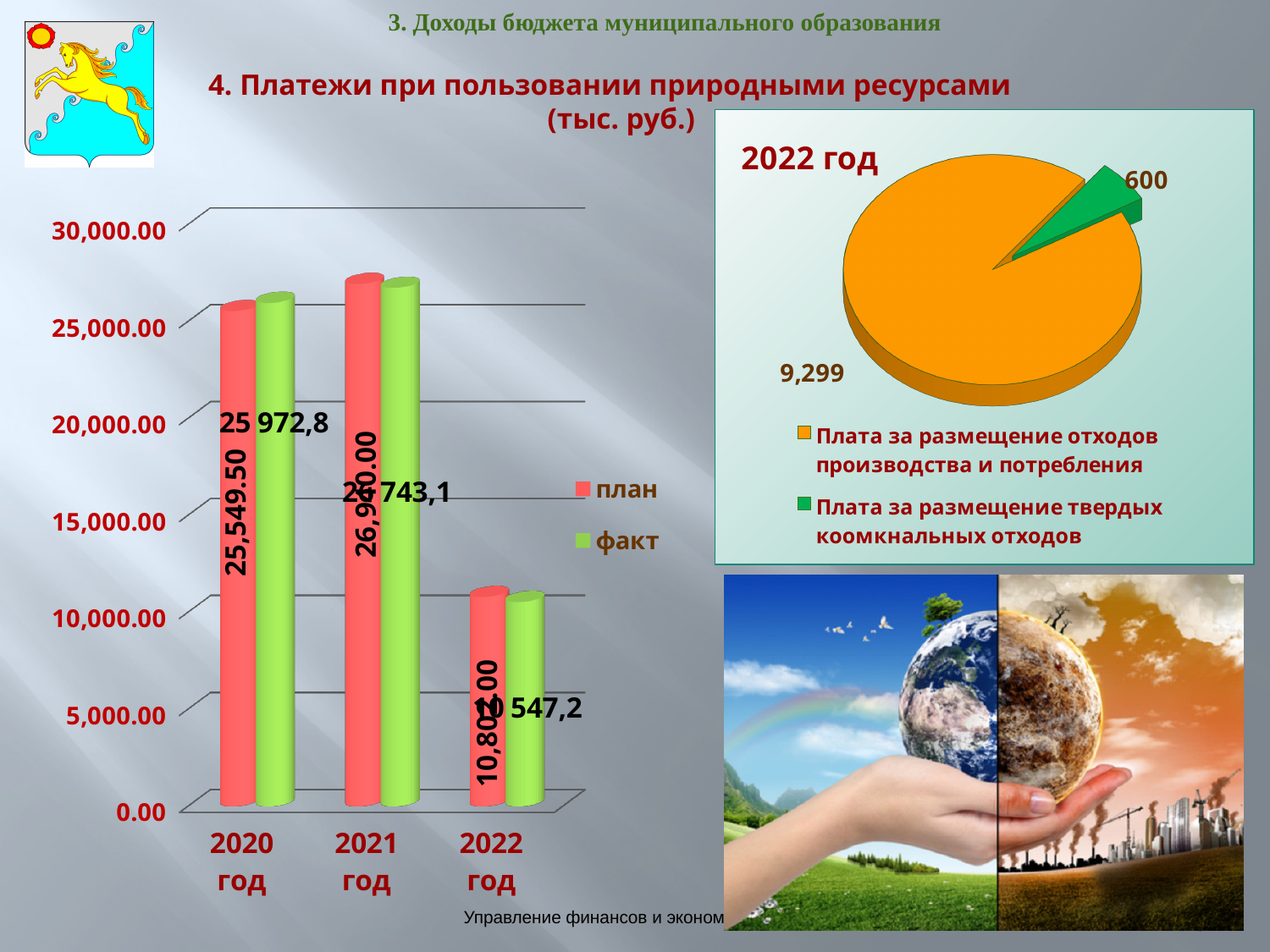
On the bar chart, what is the difference between план and факт for 2022 год? 254,8 On the bar chart, which year has the highest факт value? 2021 год On the pie chart titled 2022 год, what is the value for Плата за размещение твердых коомкнальных отходов? 600 On the bar chart, for 2020 год, which is larger: план or факт? факт On the bar chart, what is the value of факт for 2022 год? 10 547,2 On the bar chart, is the план value for 2022 год greater or less than 15,000.00? less How many series does the bar chart's legend list? 2 On the bar chart, what is the value of факт for 2020 год? 25 972,8 On the bar chart, what is the value of план for 2021 год? 26,940.00 On the pie chart titled 2022 год, what is the total of the two slices? 9,899 On the bar chart, which year has the lowest план value? 2022 год What kind of chart is the chart on the left side of the slide? bar chart